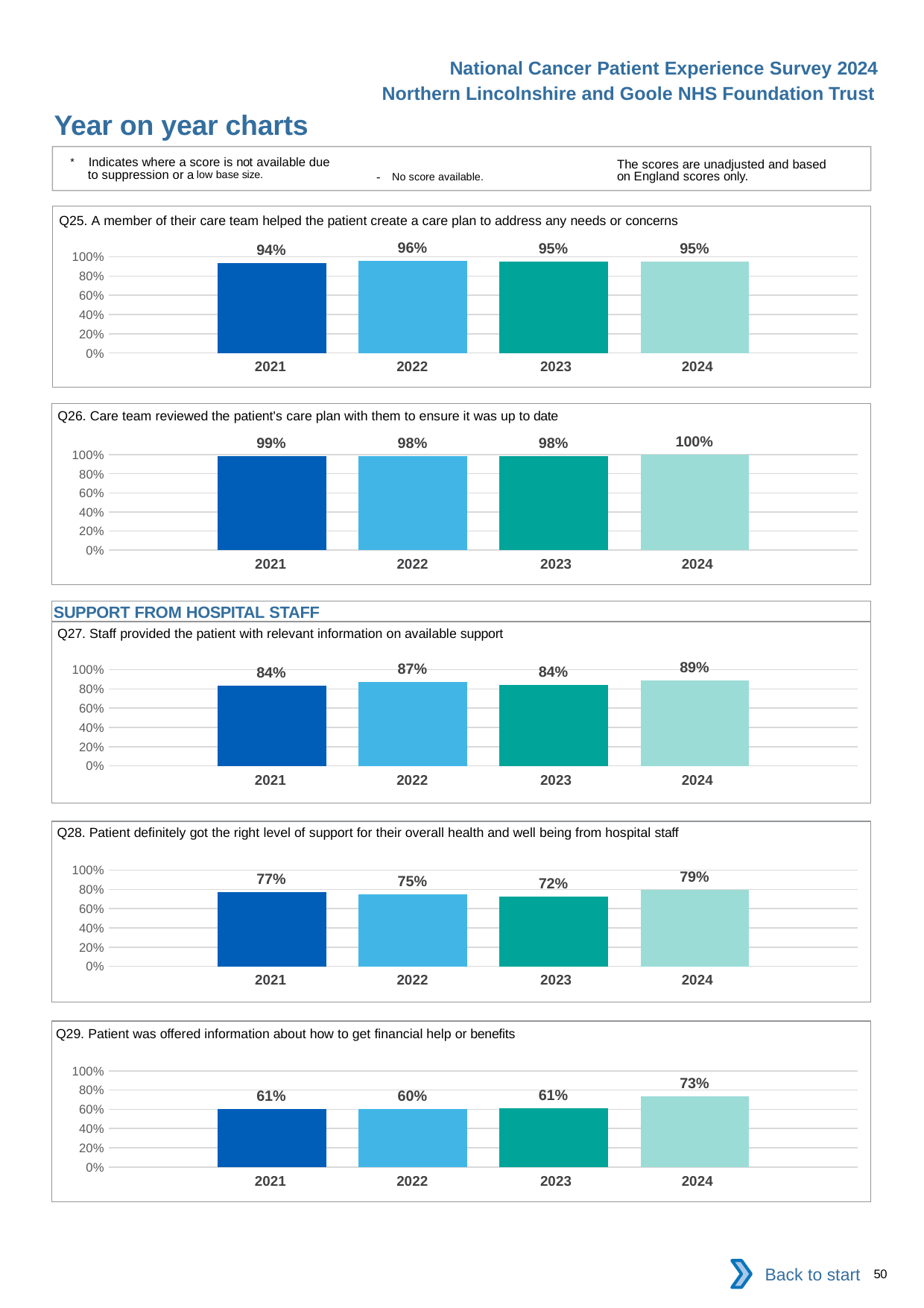
In the Q28 chart, what is the difference between the 2024 and 2021 values? 2% In the Q26 chart, what is the value for 2021? 99% In the Q26 chart, which year has the highest value? 2024 How many years are shown in the Q28 chart? 4 What kind of chart is the Q27 chart? bar chart In the Q25 chart, what is the value for 2022? 96% In the Q28 chart, which year has the lowest value? 2023 What section heading appears above the Q27 chart? SUPPORT FROM HOSPITAL STAFF In the Q29 chart, what is the value for 2024? 73% In the Q25 chart, is the value for 2021 greater or less than 80%? greater In the Q29 chart, is the value for 2022 larger or smaller than the value for 2024? smaller In the Q27 chart, what is the difference between the 2024 and 2023 values? 5%